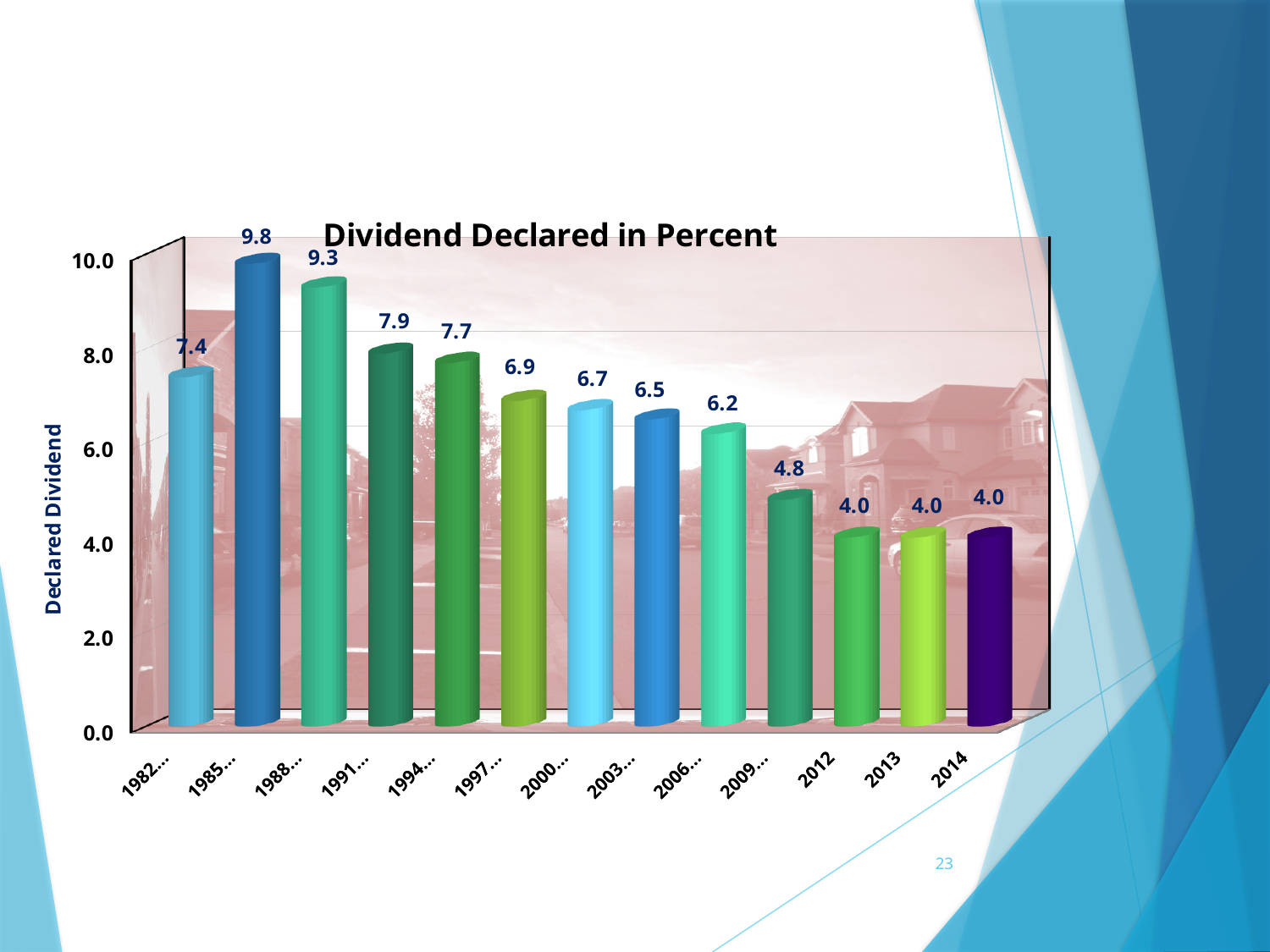
Which is larger, the value for the category beginning with 1991 or the category beginning with 1994? 1991... What is the difference between the values for the category beginning with 2009 and 2012? 0.8 What is the value of the bar for the category beginning with 1985? 9.8 Which category has the highest dividend declared? 1985... What is the difference between the values for the categories beginning with 1985 and 1988? 0.5 How many bars are plotted in the chart? 13 What is the value of the bar for the category beginning with 2009? 4.8 What is the label on the vertical axis? Declared Dividend What type of chart is shown on the slide? bar chart Do the values generally rise or fall from left to right across the chart after the 1985 bar? fall What is the dividend declared for 2014? 4.0 What is the title of the chart? Dividend Declared in Percent